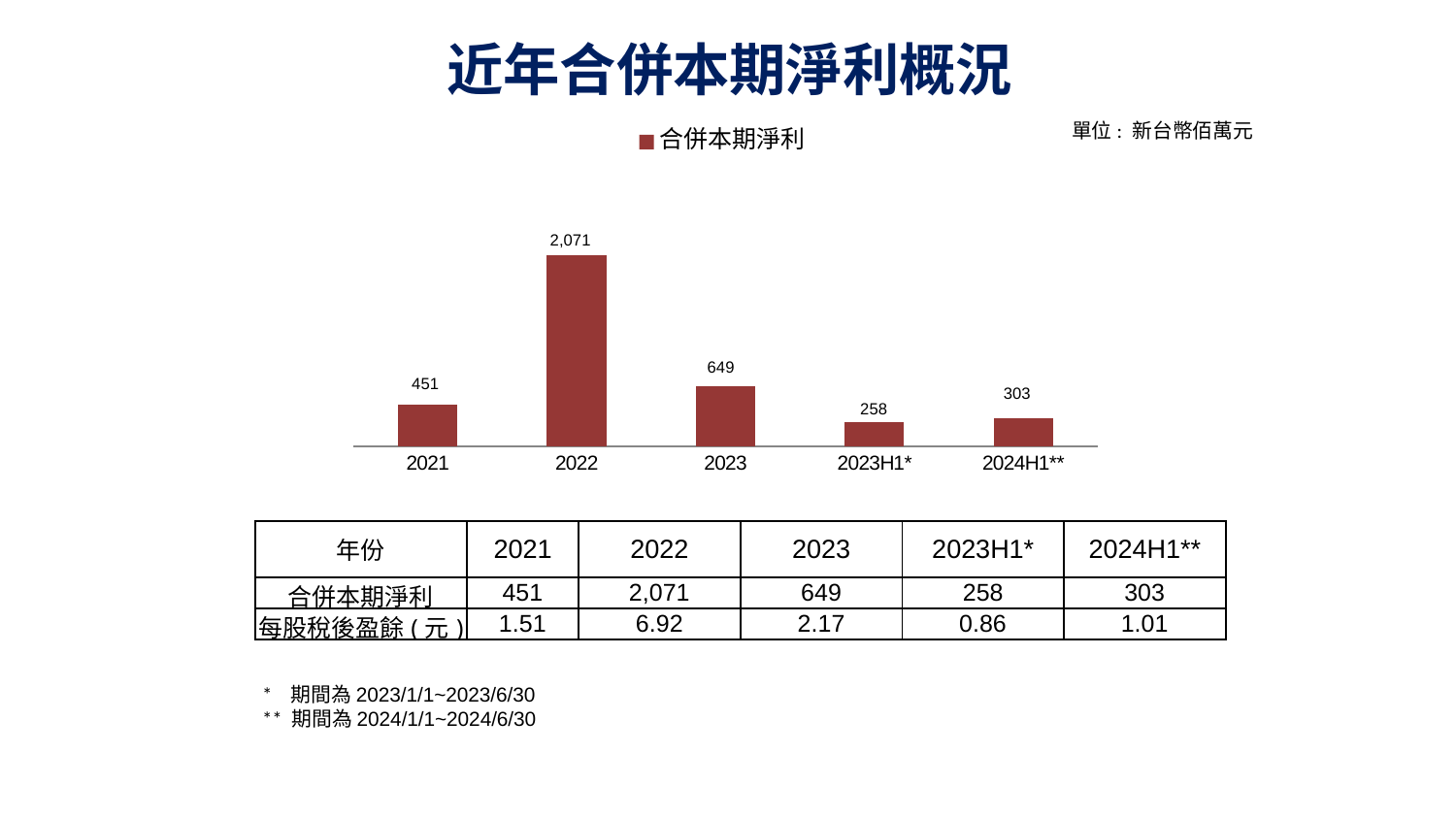
Which category has the lowest value in the chart? 2023H1* What is the difference between the values for 2022 and 2023? 1,422 Which category has the highest value in the chart? 2022 What is the value for 2022 in the chart? 2,071 What is the value for 2024H1** in the chart? 303 What is the difference between the values for 2024H1** and 2023H1*? 45 Which is larger, the value for 2021 or the value for 2023? 2023 How many categories are shown on the x axis of the chart? 5 What is the value for 2023H1* in the chart? 258 What is the series name shown in the chart legend? 合併本期淨利 How many series does the legend list? 1 What kind of chart is shown on the slide? Bar chart